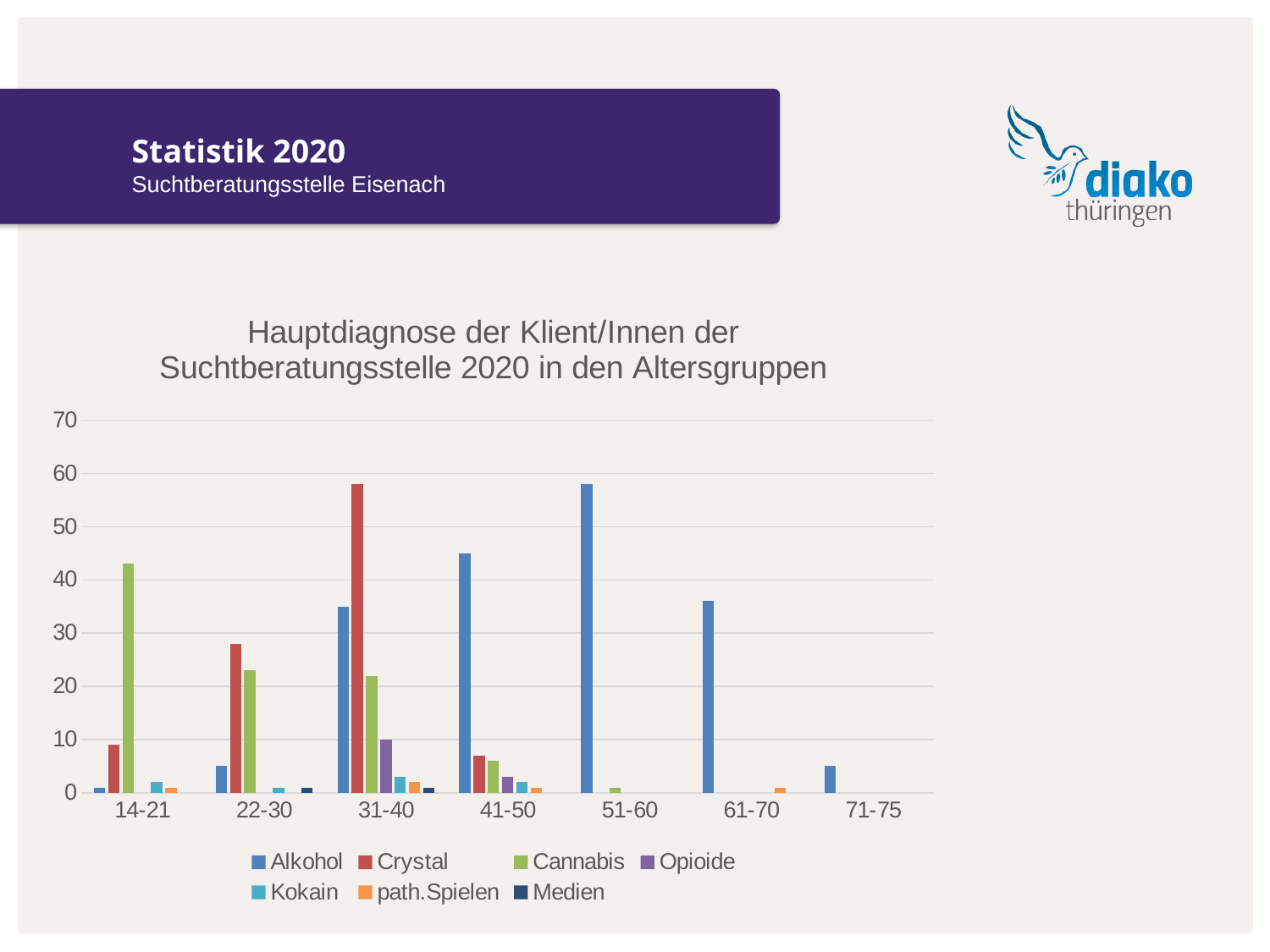
Which age group has the highest value for Cannabis? 14-21 Which age group has the highest value for Alkohol? 51-60 What kind of chart is shown on the slide? bar chart What is the title of the chart? Hauptdiagnose der Klient/Innen der Suchtberatungsstelle 2020 in den Altersgruppen How many age groups are shown on the x axis? 7 Is the value for Crystal in the 31-40 age group greater or less than 50? greater Does the value for Alkohol rise or fall from the 51-60 age group to the 71-75 age group? fall Which age group has the highest value for Crystal? 31-40 How many series does the legend list? 7 Is the value for Alkohol in the 41-50 age group greater or less than 40? greater In the 31-40 age group, which is larger: Alkohol or Crystal? Crystal Is the value for Cannabis in the 14-21 age group greater or less than 40? greater